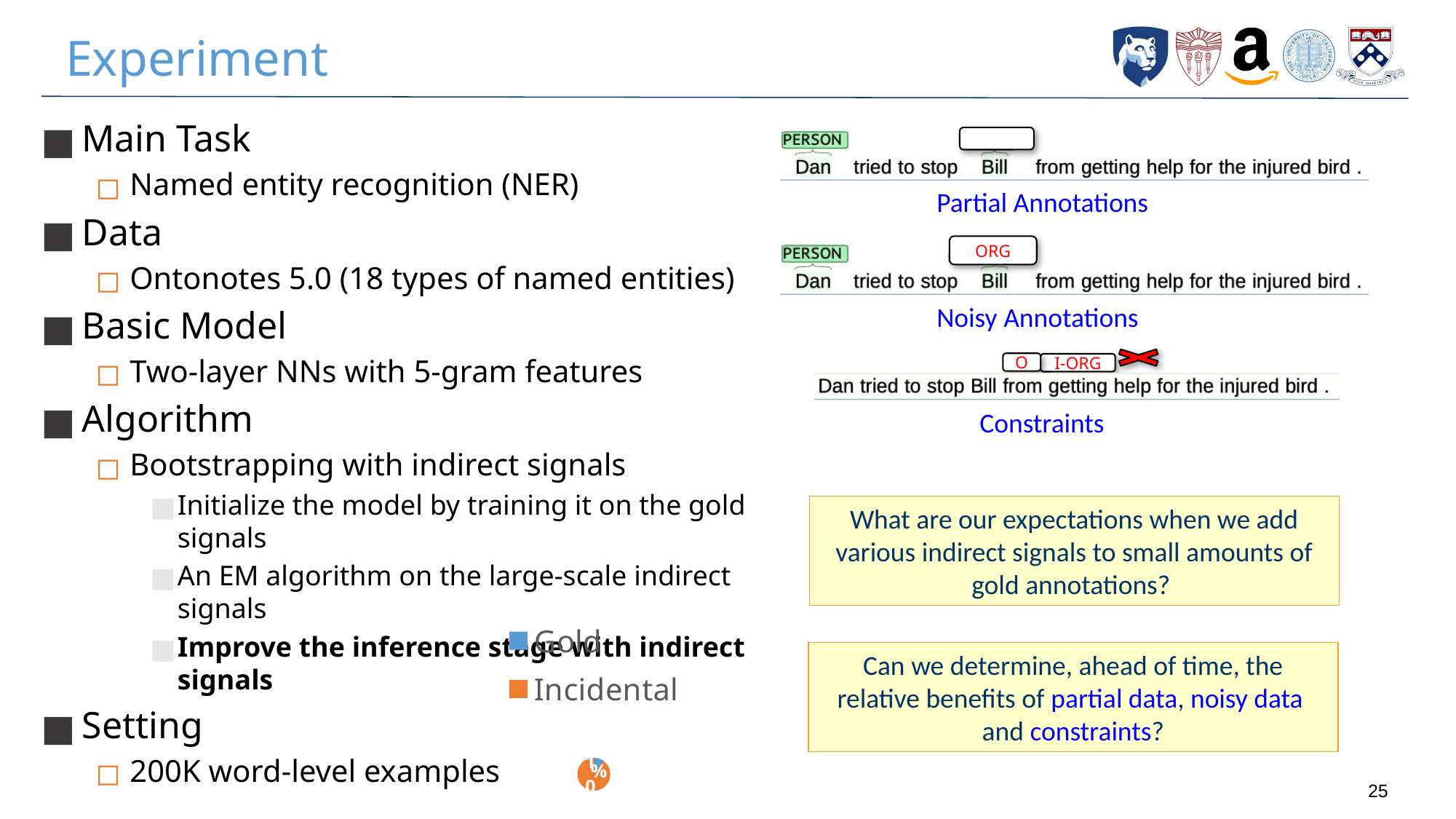
Which colour represents Incidental in the pie chart? orange How many entries does the chart's legend list? 2 What kind of chart is shown on the slide? pie chart Which slice of the pie chart is larger, Gold or Incidental? Incidental What are the two legend entries of the pie chart? Gold and Incidental